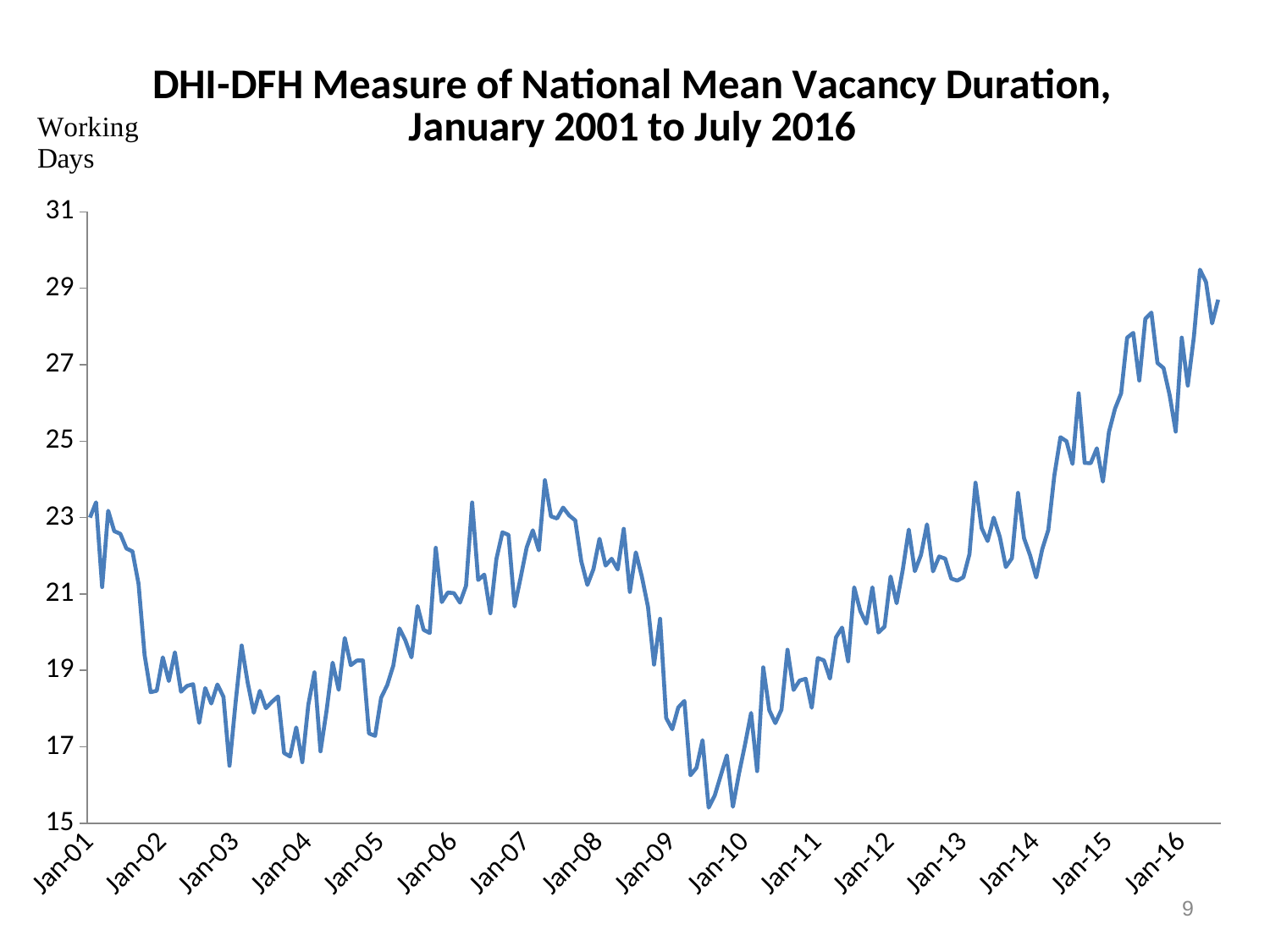
Is the value at Jan-01 greater or less than 21? greater How many year labels are shown along the x axis? 16 Between Jan-10 and Jan-16, does the series generally rise or fall? rise What kind of chart is shown on the slide? line chart Is the value at Jan-05 greater or less than 21? less What unit is the vertical axis labelled with? Working Days What is the title of the chart? DHI-DFH Measure of National Mean Vacancy Duration, January 2001 to July 2016 In which year does the series reach its lowest point? 2009 Is the value at Jan-16 greater or less than 25? greater In which year does the series reach its highest point? 2016